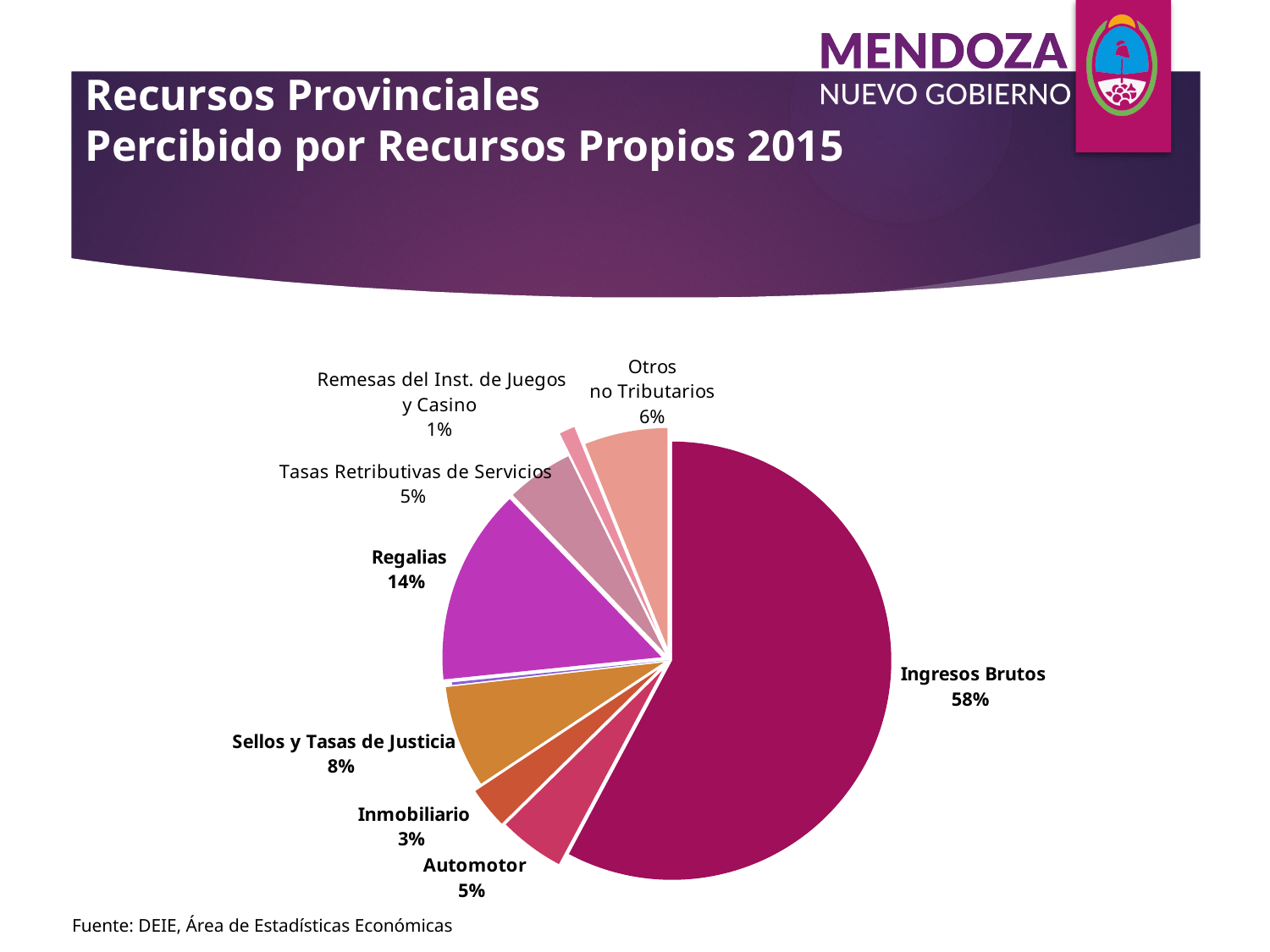
What percentage is shown for Sellos y Tasas de Justicia? 8% Which labeled category has the smallest share of the pie? Remesas del Inst. de Juegos y Casino What kind of chart is shown on the slide? pie chart What share of the pie does Ingresos Brutos represent? 58% Which category has the largest share of the pie? Ingresos Brutos What percentage is shown for Inmobiliario? 3% Which is larger, the share for Sellos y Tasas de Justicia or the share for Otros no Tributarios? Sellos y Tasas de Justicia What is the combined share of Automotor and Inmobiliario? 8% What percentage is shown for Otros no Tributarios? 6% What source is cited below the chart? DEIE, Área de Estadísticas Económicas What is the difference in percentage points between Ingresos Brutos and Regalias? 44 What percentage is shown for Regalias? 14%